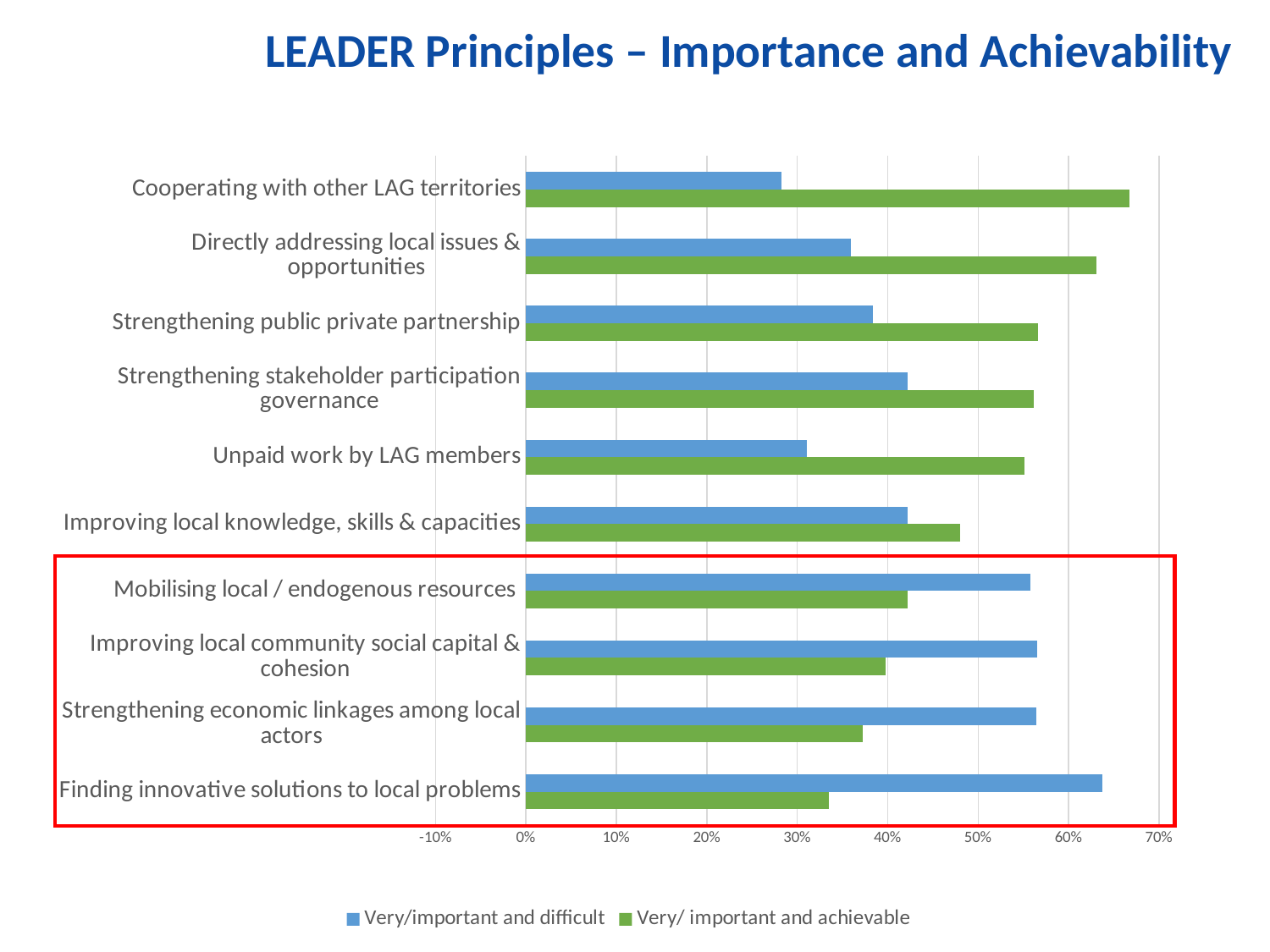
Is the 'Very/important and difficult' value for 'Cooperating with other LAG territories' greater or less than 30%? less Is the 'Very/ important and achievable' value for 'Cooperating with other LAG territories' greater or less than 60%? greater Which category has the highest value for 'Very/important and difficult'? Finding innovative solutions to local problems For 'Strengthening economic linkages among local actors', which series has the larger value: 'Very/important and difficult' or 'Very/ important and achievable'? Very/important and difficult Which category has the highest value for 'Very/ important and achievable'? Cooperating with other LAG territories What kind of chart is shown on the slide? bar chart Is the 'Very/important and difficult' value for 'Finding innovative solutions to local problems' greater or less than 60%? greater What is the title of the chart on the slide? LEADER Principles – Importance and Achievability How many series does the legend list? 2 For 'Unpaid work by LAG members', which series has the larger value: 'Very/important and difficult' or 'Very/ important and achievable'? Very/ important and achievable Which category has the lowest value for 'Very/ important and achievable'? Finding innovative solutions to local problems How many categories (LEADER principles) are plotted on the chart? 10